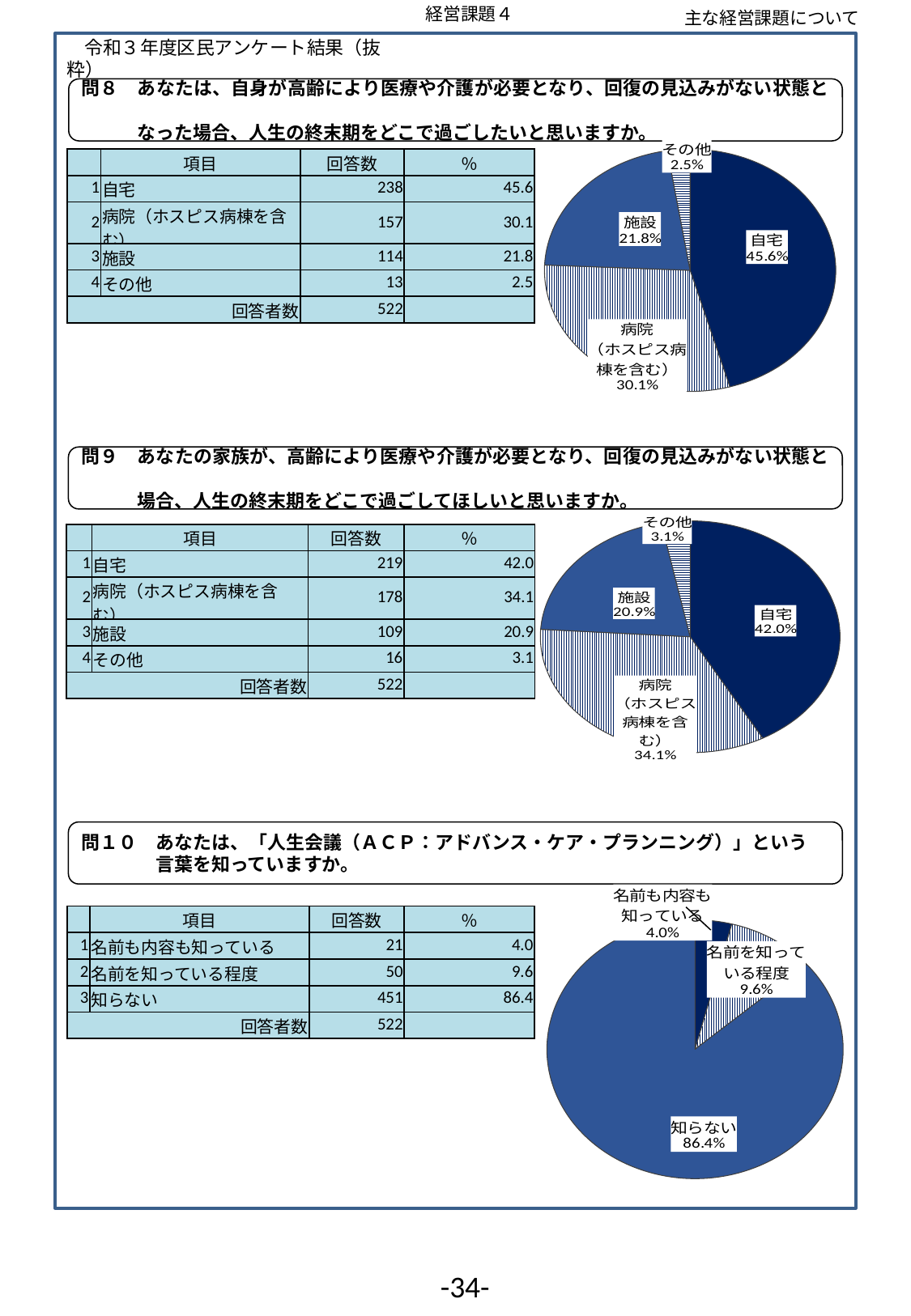
In the 問9 pie chart (middle), which is larger, 病院（ホスピス病棟を含む） or 施設? 病院（ホスピス病棟を含む） How many slices does the 問8 pie chart (top) have? 4 In the 問9 pie chart (middle), what share is labelled for その他? 3.1% In the 問10 pie chart (bottom), which category has the smallest slice? 名前も内容も知っている In the 問10 pie chart (bottom), what share is labelled for 知らない? 86.4% In the 問9 pie chart (middle), what share is labelled for 施設? 20.9% In the 問8 pie chart (top), which category has the smallest slice? その他 In the 問8 pie chart (top), what is the difference in percentage points between 自宅 and 病院（ホスピス病棟を含む）? 15.5 How many slices does the 問10 pie chart (bottom) have? 3 What type of chart is used for 問10 (bottom)? Pie chart In the 問8 pie chart (top), what share is labelled for 自宅? 45.6% In the 問9 pie chart (middle), which category has the largest slice? 自宅